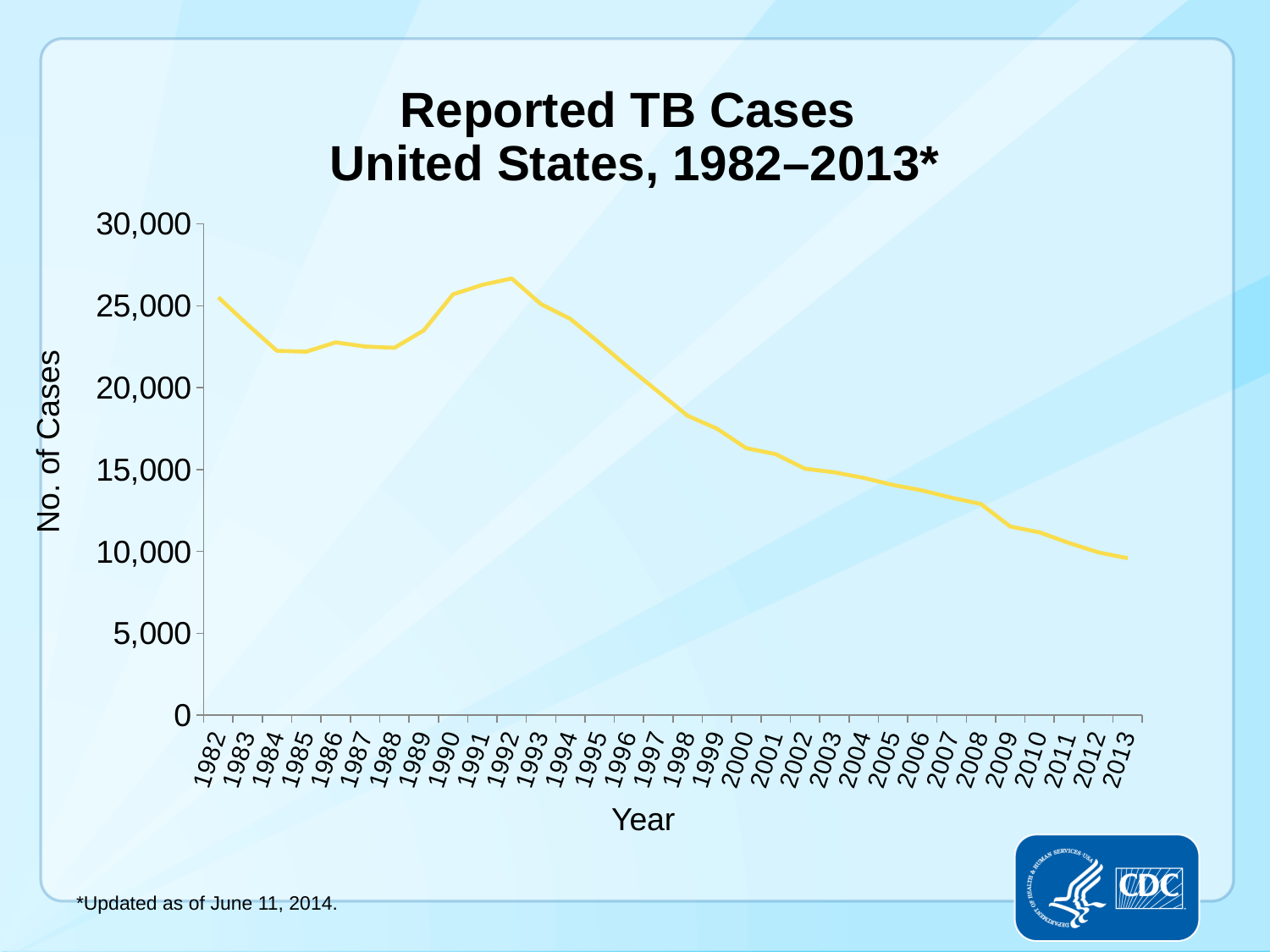
Is the value for 2013 greater or less than 10,000? less Which year has more reported TB cases, 1992 or 2013? 1992 What is the label on the vertical axis? No. of Cases How many years are plotted along the x axis? 32 In which year does the line reach its lowest value? 2013 In which year does the line reach its highest value? 1992 Is the value for 1998 greater or less than 20,000? less Is the value for 1992 greater or less than 25,000? greater What kind of chart is shown on the slide? line chart From 1992 to 2013, do the reported TB cases rise or fall? fall What is the title of the chart? Reported TB Cases United States, 1982–2013*